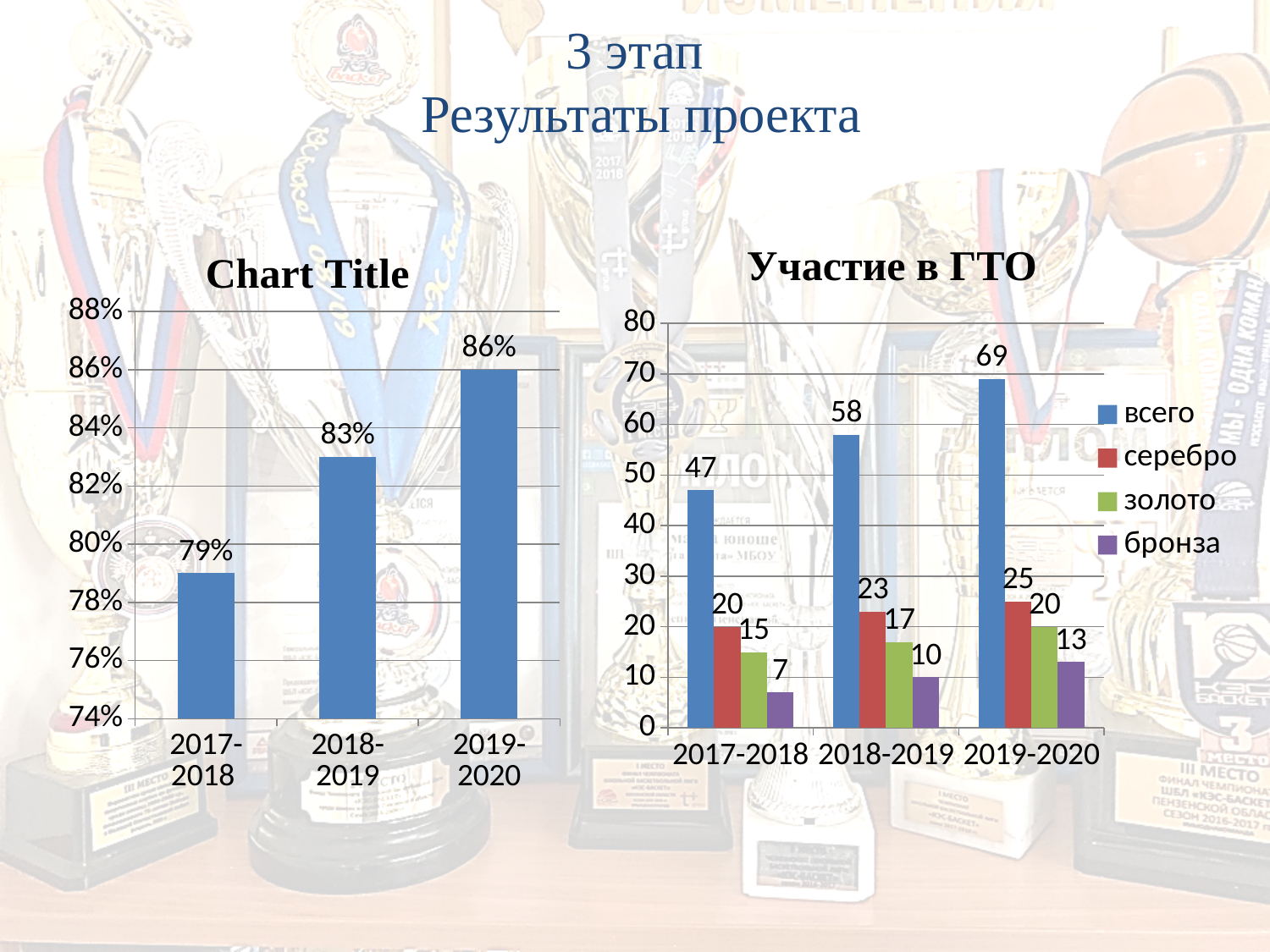
In the chart titled "Chart Title" on the left, do the values rise or fall from 2017-2018 to 2019-2020? rise In the chart "Участие в ГТО", how many series does the legend list? 4 What kind of chart is "Участие в ГТО"? bar chart In the chart "Участие в ГТО", which is larger for 2019-2020: серебро or золото? серебро In the chart "Участие в ГТО", what is the difference between всего in 2019-2020 and всего in 2017-2018? 22 In the chart titled "Chart Title" on the left, how many categories are shown on the x axis? 3 In the chart titled "Chart Title" on the left, what is the value for 2018-2019? 83% In the chart "Участие в ГТО", what is the value of бронза for 2017-2018? 7 In the chart titled "Chart Title" on the left, what is the difference between the 2019-2020 and 2017-2018 values? 7% In the chart "Участие в ГТО", what is the value of всего for 2018-2019? 58 In the chart "Участие в ГТО", which year has the lowest value for золото? 2017-2018 In the chart titled "Chart Title" on the left, which year has the highest value? 2019-2020